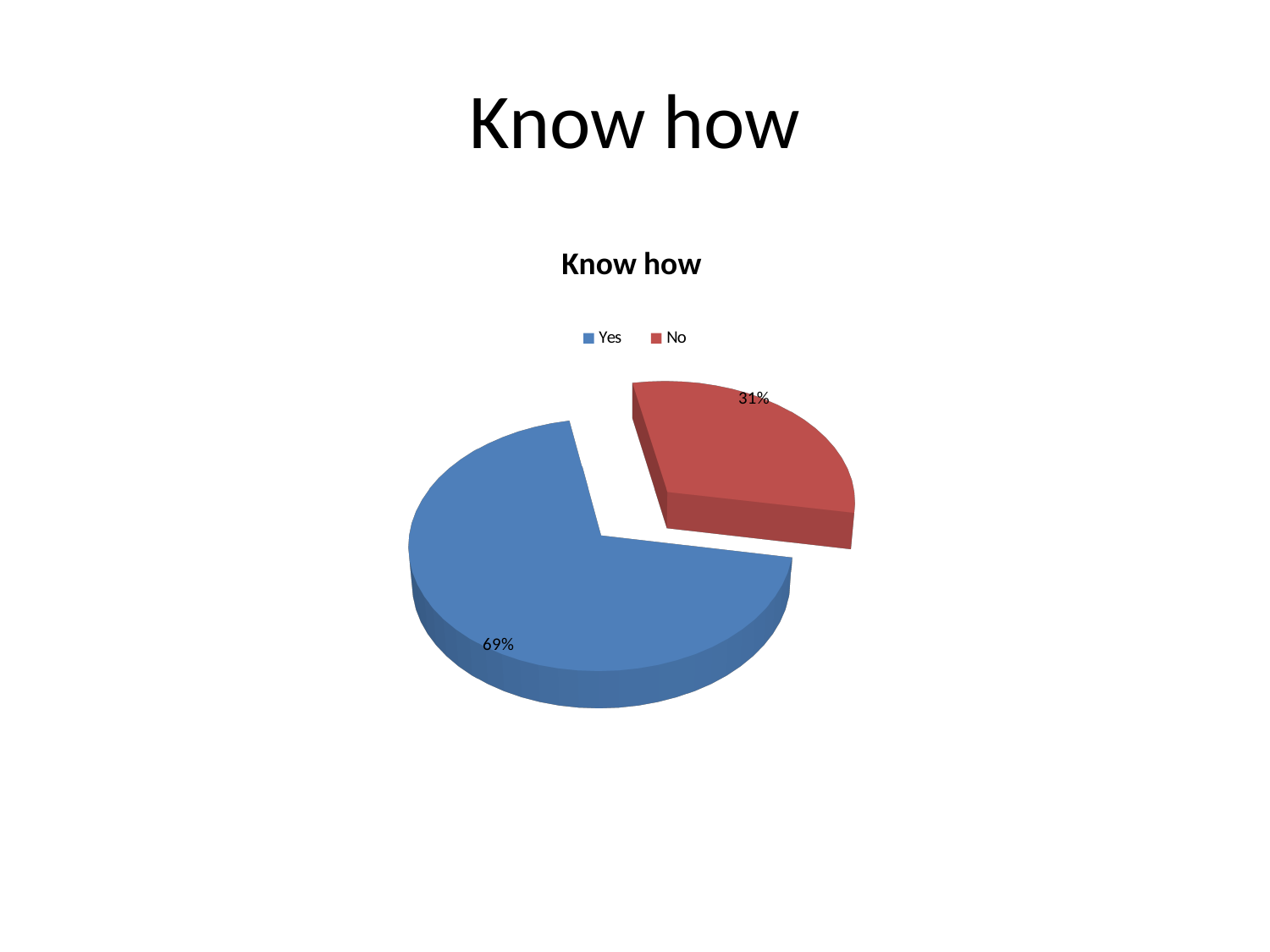
How many entries does the legend list? 2 What colour is the No slice? red How many categories does the pie chart have? 2 What is the title of the chart? Know how Which category has the smallest slice of the pie? No What is the difference in percentage points between the Yes and No slices? 38 Which is larger, the Yes slice or the No slice? Yes What kind of chart is shown on the slide? pie chart What share of the pie does the Yes slice represent? 69% What share of the pie does the No slice represent? 31% Which category has the largest slice of the pie? Yes